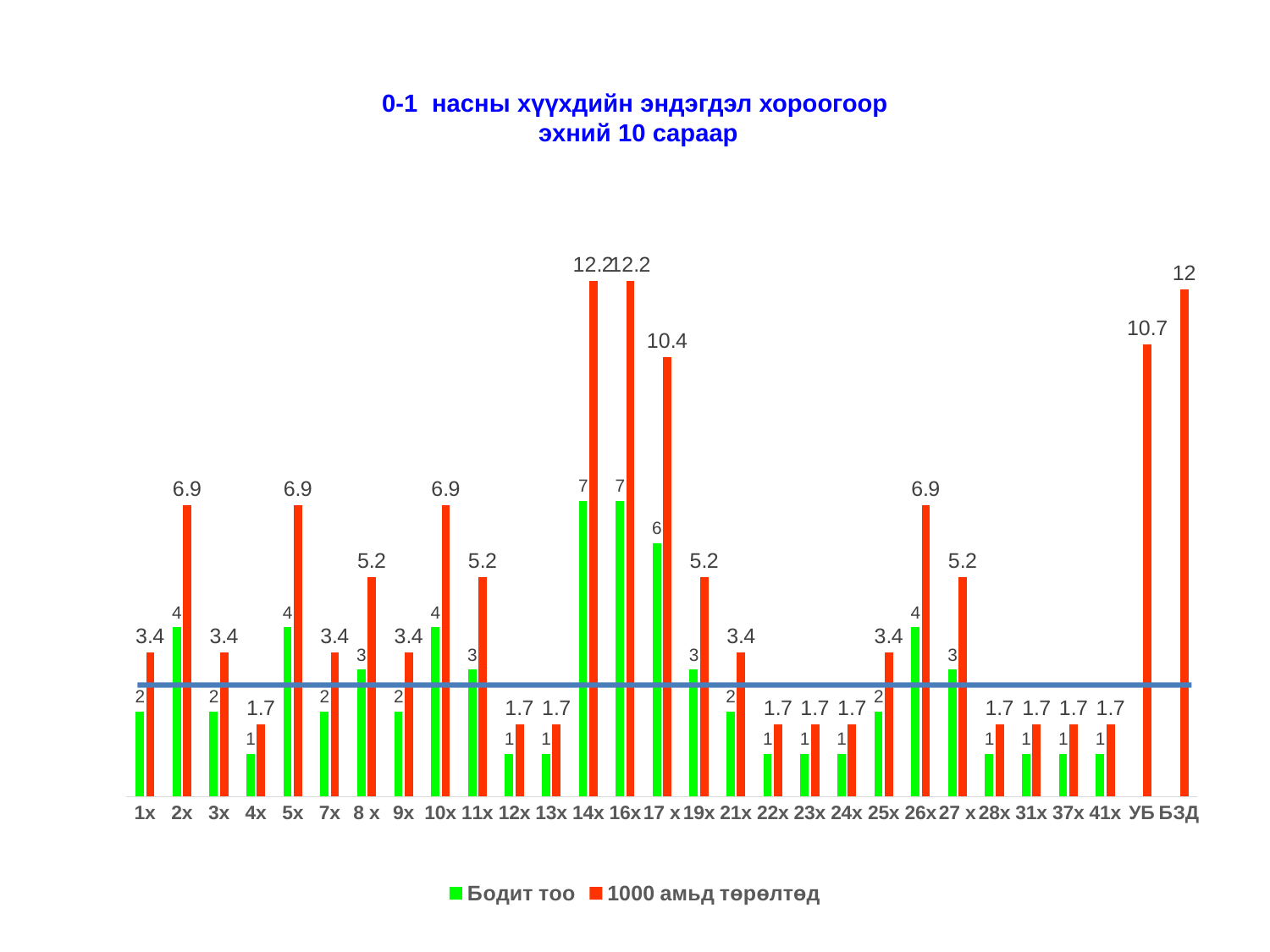
How many series does the legend list? 2 Which is larger, the "1000 амьд төрөлтөд" value for 2х or for 8 х? 2х What is the value of the "1000 амьд төрөлтөд" series for 17 х? 10.4 What is the value of the "Бодит тоо" series for 26х? 4 What is the value of the "Бодит тоо" series for 14х? 7 What is the difference between the "1000 амьд төрөлтөд" values for 16х and 17 х? 1.8 What is the value of the "1000 амьд төрөлтөд" series for УБ? 10.7 Which is larger, the "Бодит тоо" value for 17 х or for 19х? 17 х What kind of chart is shown on the slide? Bar chart What is the difference between the "1000 амьд төрөлтөд" values for БЗД and УБ? 1.3 How many categories are shown on the x axis? 29 What is the value of the "1000 амьд төрөлтөд" series for БЗД? 12